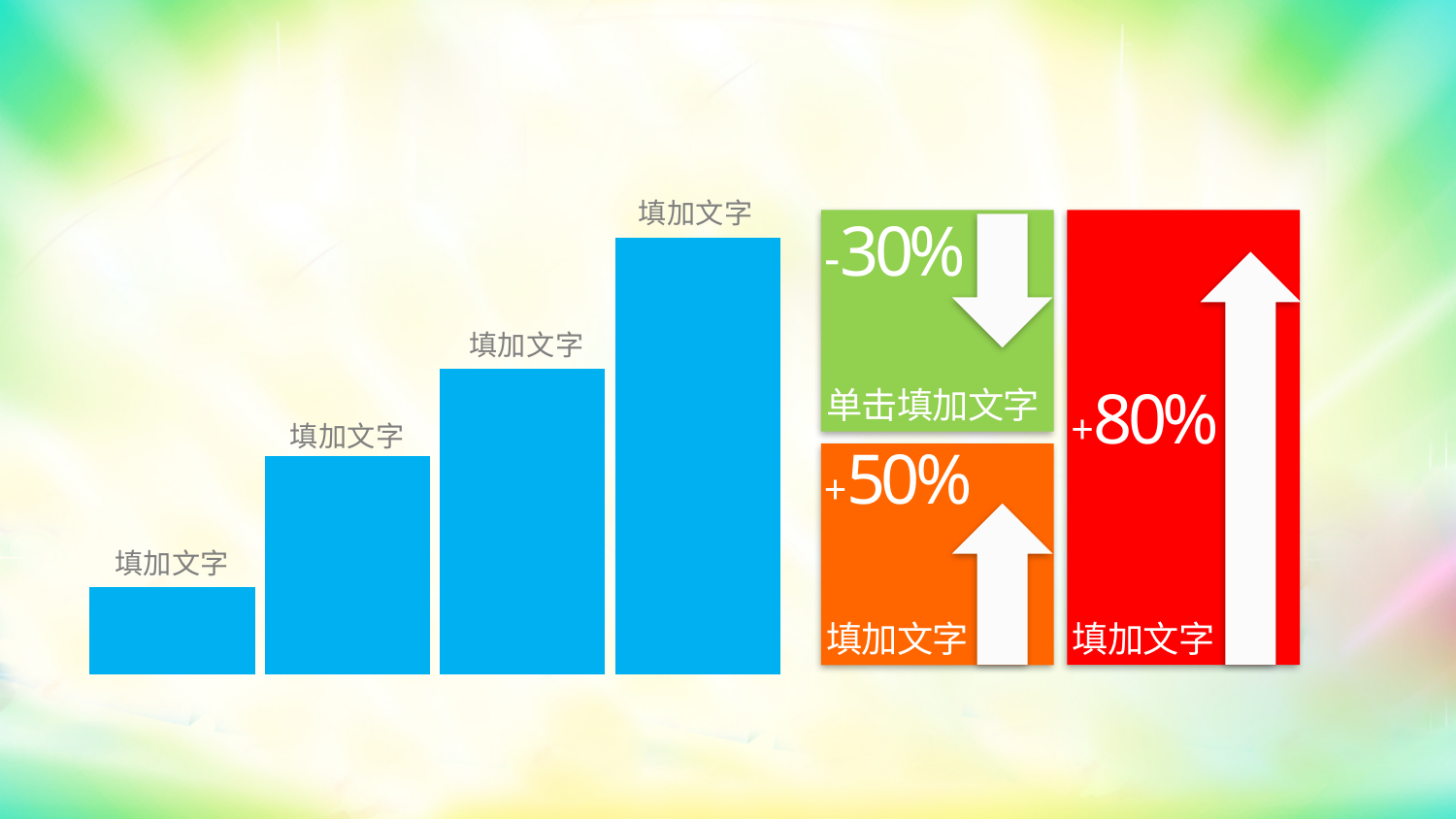
Which bar is the tallest in the chart? the rightmost (fourth) bar What kind of chart is shown on the slide? bar chart Do the bar heights rise or fall from left to right? rise How many bars does the chart have? 4 Which is taller, the second bar or the third bar? the third bar Which is taller, the first bar or the fourth bar? the fourth bar Which bar is the shortest in the chart? the leftmost (first) bar What label text appears above each bar in the chart? 填加文字 What colour are the bars in the chart? blue